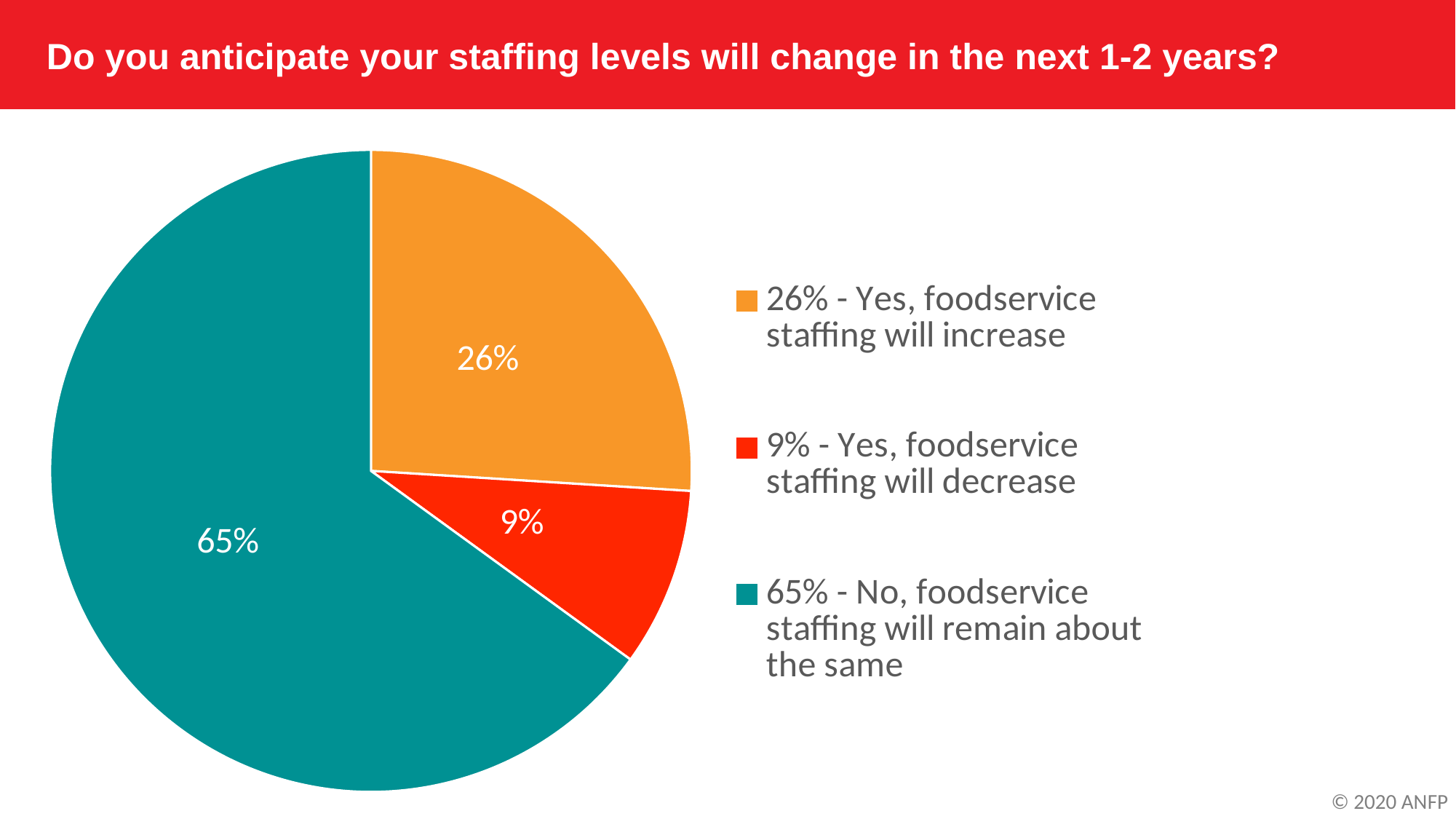
Which response has the smallest share of the pie? Yes, foodservice staffing will decrease What is the title of the slide? Do you anticipate your staffing levels will change in the next 1-2 years? What colour is the slice for 'No, foodservice staffing will remain about the same'? teal How many entries does the legend list? 3 What share of respondents said foodservice staffing will increase? 26% Which response has the largest share of the pie? No, foodservice staffing will remain about the same How many slices does the pie chart have? 3 Which is larger: the share saying staffing will increase or the share saying it will decrease? Yes, foodservice staffing will increase What share of respondents said foodservice staffing will decrease? 9% What kind of chart is shown on the slide? pie chart What is the difference in percentage points between the share saying staffing will remain about the same and the share saying it will increase? 39 What share of respondents said foodservice staffing will remain about the same? 65%